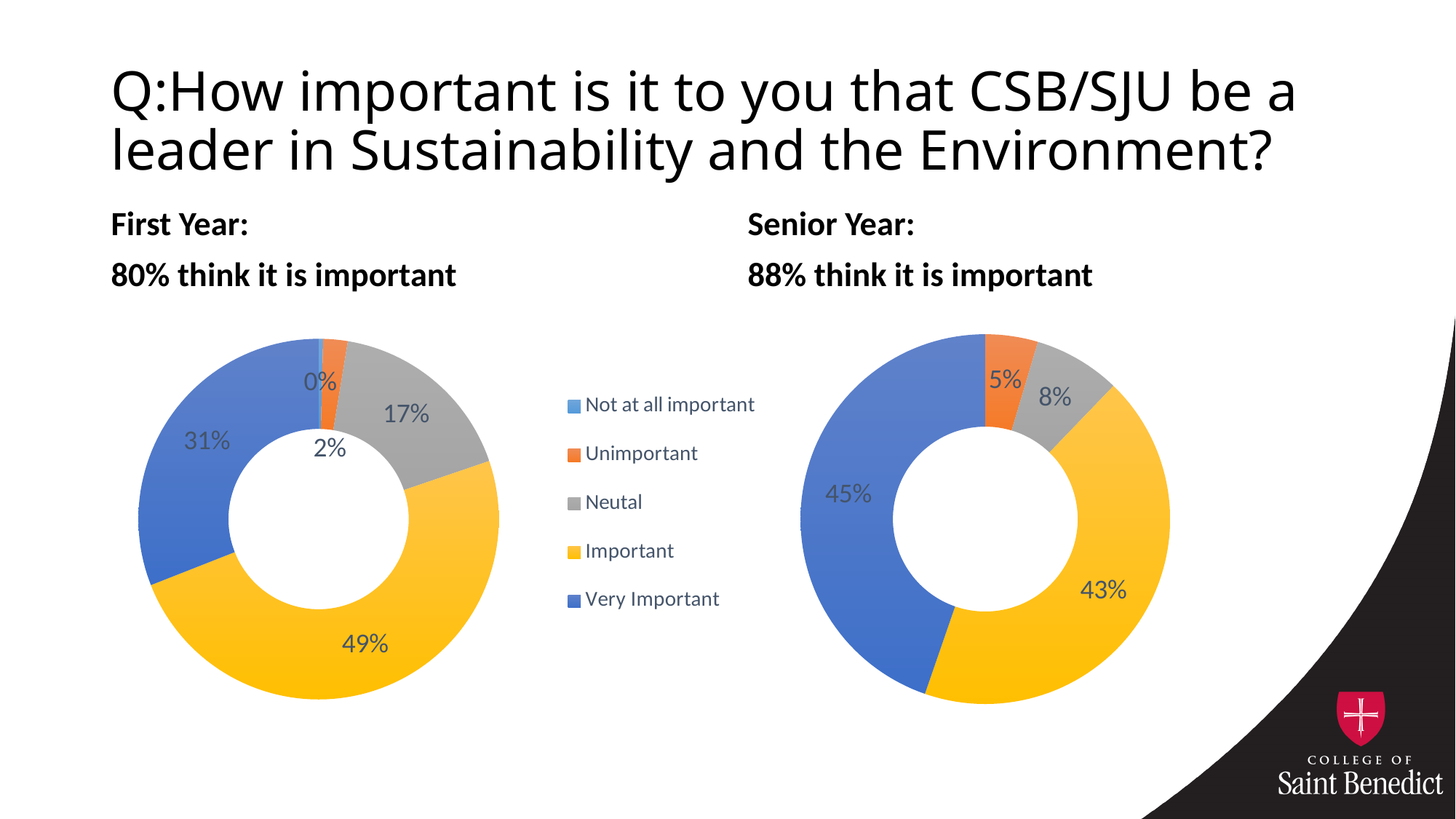
In the Senior Year chart, which is larger: the share for Important or the share for Very Important? Very Important What kind of chart is used for the First Year data? Doughnut chart In the Senior Year chart, what share of respondents said it is Very Important? 45% How many entries does the legend list? 5 What is the difference between the Very Important share in the Senior Year chart and the Very Important share in the First Year chart? 14% In the First Year chart, what share of respondents said it is Very Important? 31% In the First Year chart, which response has the largest share? Important In the First Year chart, what share of respondents were Neutral? 17% In the Senior Year chart, which response has the largest share? Very Important In the Senior Year chart, what share of respondents said it is Unimportant? 5% In the Senior Year chart, what share of respondents were Neutral? 8% In the First Year chart, what share of respondents said it is Important? 49%